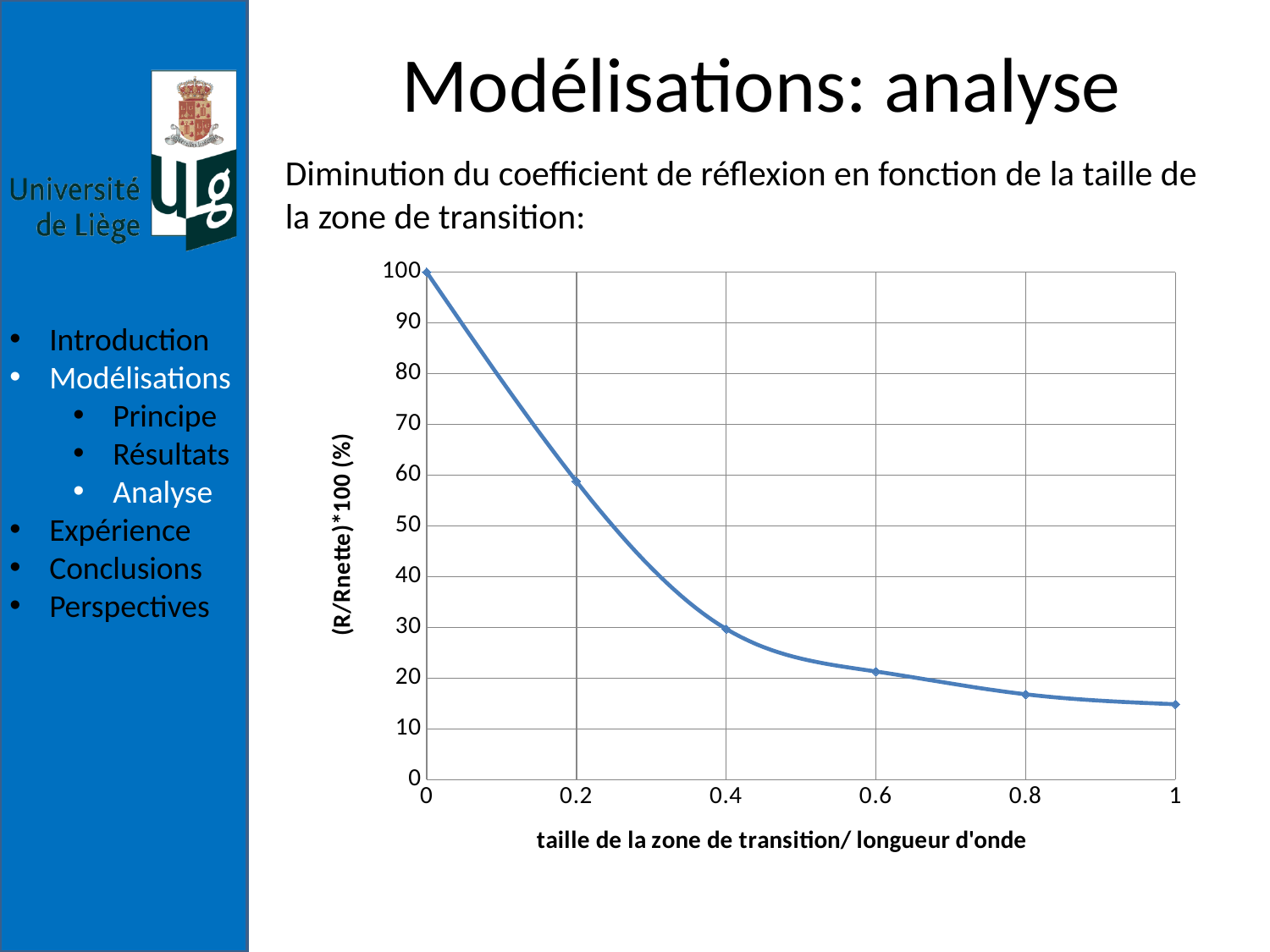
What is the title of the x axis? taille de la zone de transition/ longueur d'onde What is the title of the y axis? (R/Rnette)*100 (%) Is the value at x = 0.8 greater or less than 20? less What is the value of (R/Rnette)*100 at x = 0? 100 Do the values rise or fall as the x axis increases from 0 to 1? fall Is the value at x = 0.2 greater or less than 50? greater What kind of chart is shown on the slide? line chart How many data points are plotted on the line? 6 At which x value is the plotted value highest? 0 Is the value at x = 0.4 greater or less than 40? less At which x value is the plotted value lowest? 1 Which has the larger value, x = 0.2 or x = 0.4? 0.2